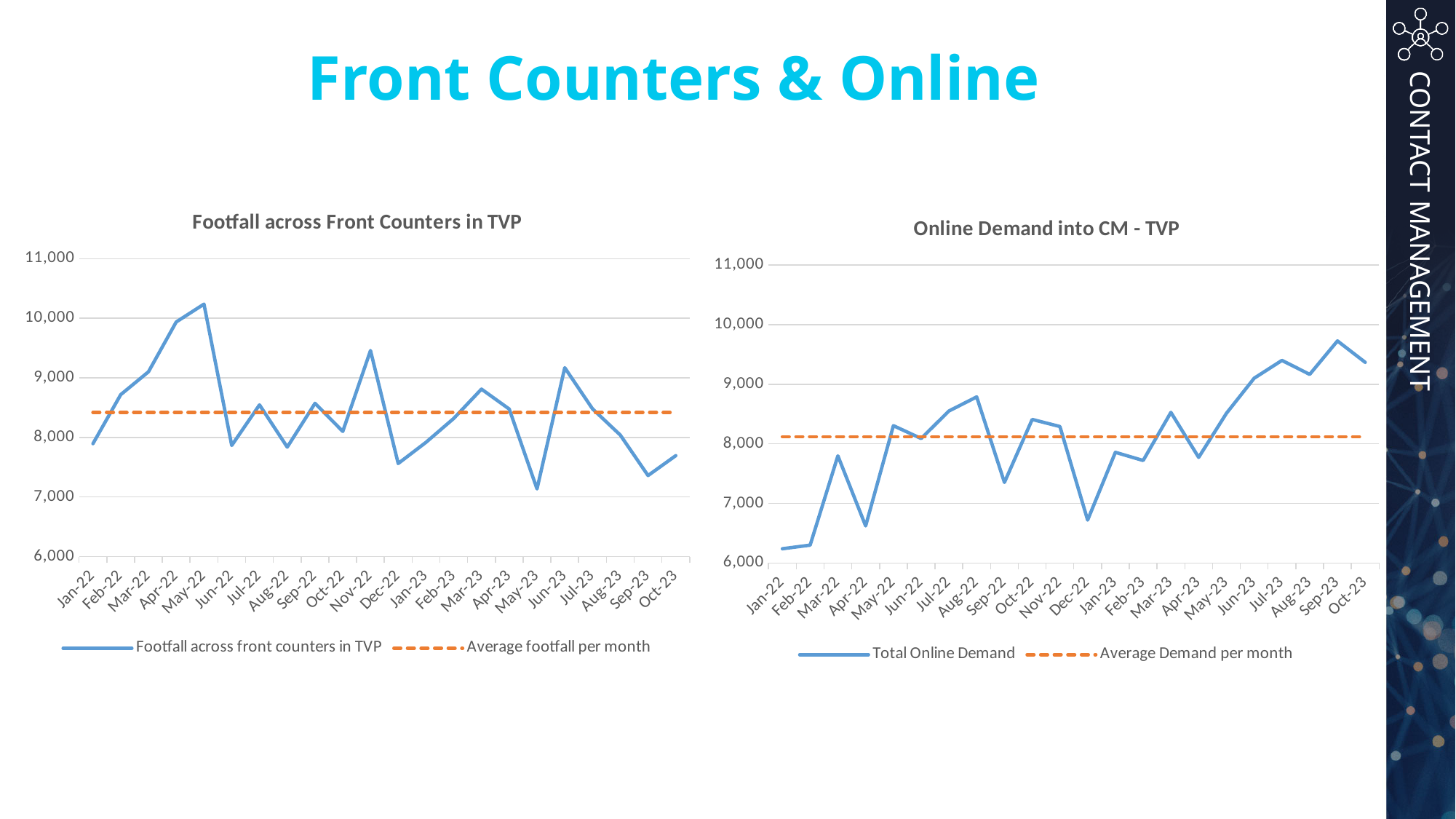
In the "Footfall across Front Counters in TVP" chart, which month has the highest footfall? May-22 How many months are plotted on the x axis of the "Online Demand into CM - TVP" chart? 22 In the "Online Demand into CM - TVP" chart, which is larger: the total online demand for Oct-23 or for Jan-22? Oct-23 In the "Footfall across Front Counters in TVP" chart, which month has the lowest footfall? May-23 In the "Footfall across Front Counters in TVP" chart, is the footfall for May-22 greater or less than 10,000? greater What kind of chart is "Footfall across Front Counters in TVP"? line chart What does the dashed orange line represent in the "Online Demand into CM - TVP" chart? Average Demand per month In the "Online Demand into CM - TVP" chart, which month has the lowest total online demand? Jan-22 In the "Online Demand into CM - TVP" chart, does total online demand overall rise or fall from Jan-22 to Oct-23? rise In the "Online Demand into CM - TVP" chart, which month has the highest total online demand? Sep-23 How many series does the legend of the "Footfall across Front Counters in TVP" chart list? 2 In the "Online Demand into CM - TVP" chart, is the total online demand for Dec-22 greater or less than 7,000? less